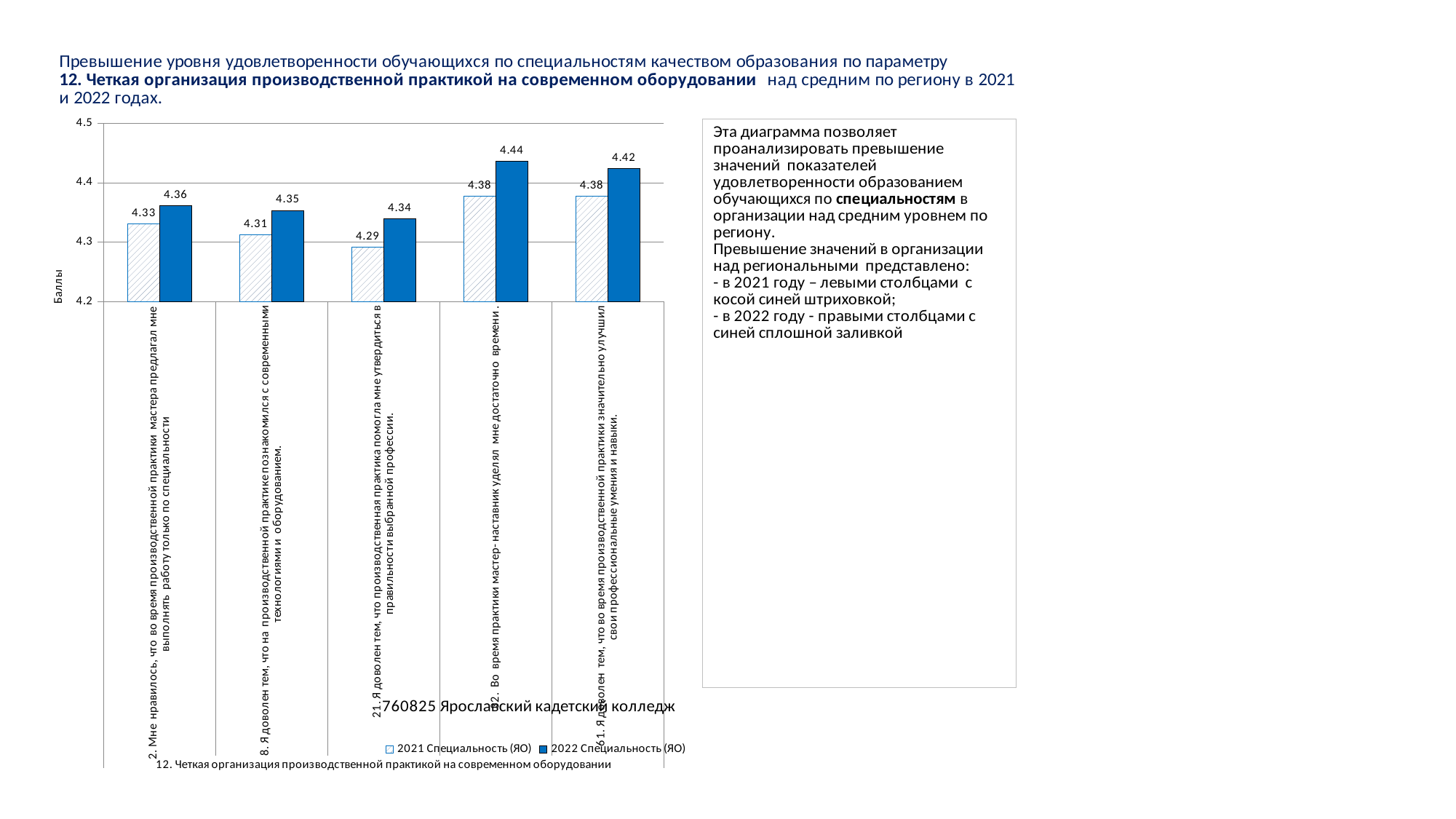
What is the difference between the 2022 and 2021 values for statement 21? 0.05 What is the 2022 Специальность (ЯО) value for statement 32 (Во время практики мастер-наставник уделял мне достаточно времени)? 4.44 Which statement has the highest 2022 Специальность (ЯО) value? 32. Во время практики мастер-наставник уделял мне достаточно времени What is the 2021 Специальность (ЯО) value for statement 8 (познакомился с современными технологиями и оборудованием)? 4.31 How many categories (statements) are plotted on the x axis? 5 What is the difference between the 2022 and 2021 values for statement 32? 0.06 What is the 2021 Специальность (ЯО) value for statement 21 (производственная практика помогла мне утвердиться в правильности выбранной профессии)? 4.29 For statement 61, which is larger: the 2021 value or the 2022 value? 2022 value (4.42) What is the label of the y axis? Баллы What type of chart is shown on the slide? Bar chart How many series does the legend list? 2 Which statement has the lowest 2021 Специальность (ЯО) value? 21. Я доволен тем, что производственная практика помогла мне утвердиться в правильности выбранной профессии